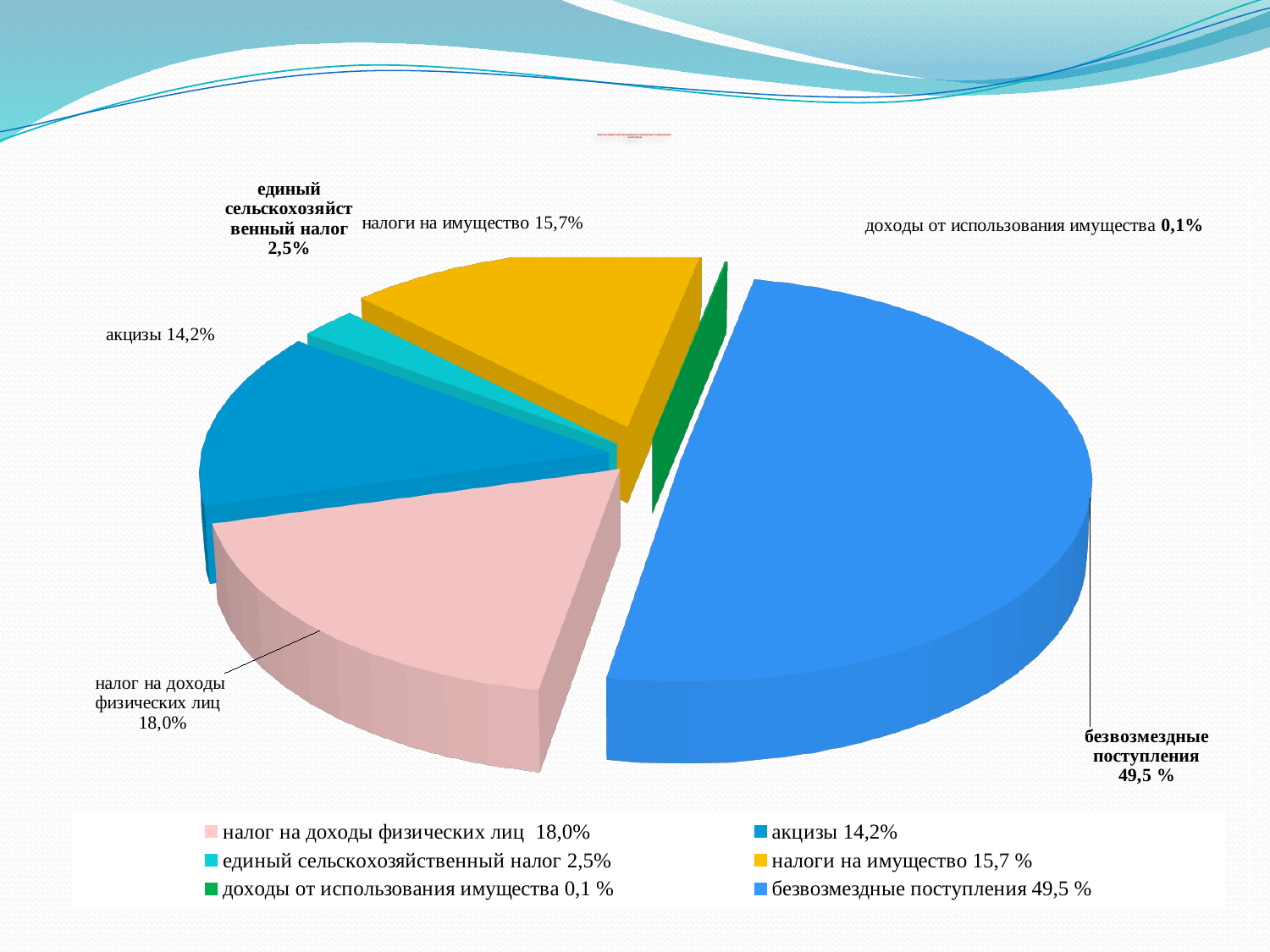
How many entries does the legend list? 6 What kind of chart is shown on the slide? pie chart How many slices does the pie chart have? 6 What is the value shown for налог на доходы физических лиц? 18,0% What is the value shown for акцизы? 14,2% Which is larger, налоги на имущество or акцизы? налоги на имущество What is the value shown for единый сельскохозяйственный налог? 2,5% What share of the pie is безвозмездные поступления? 49,5% Which category has the smallest slice of the pie? доходы от использования имущества What is the value shown for доходы от использования имущества? 0,1% What is the difference in percentage points between безвозмездные поступления and налог на доходы физических лиц? 31,5 Which category has the largest slice of the pie? безвозмездные поступления